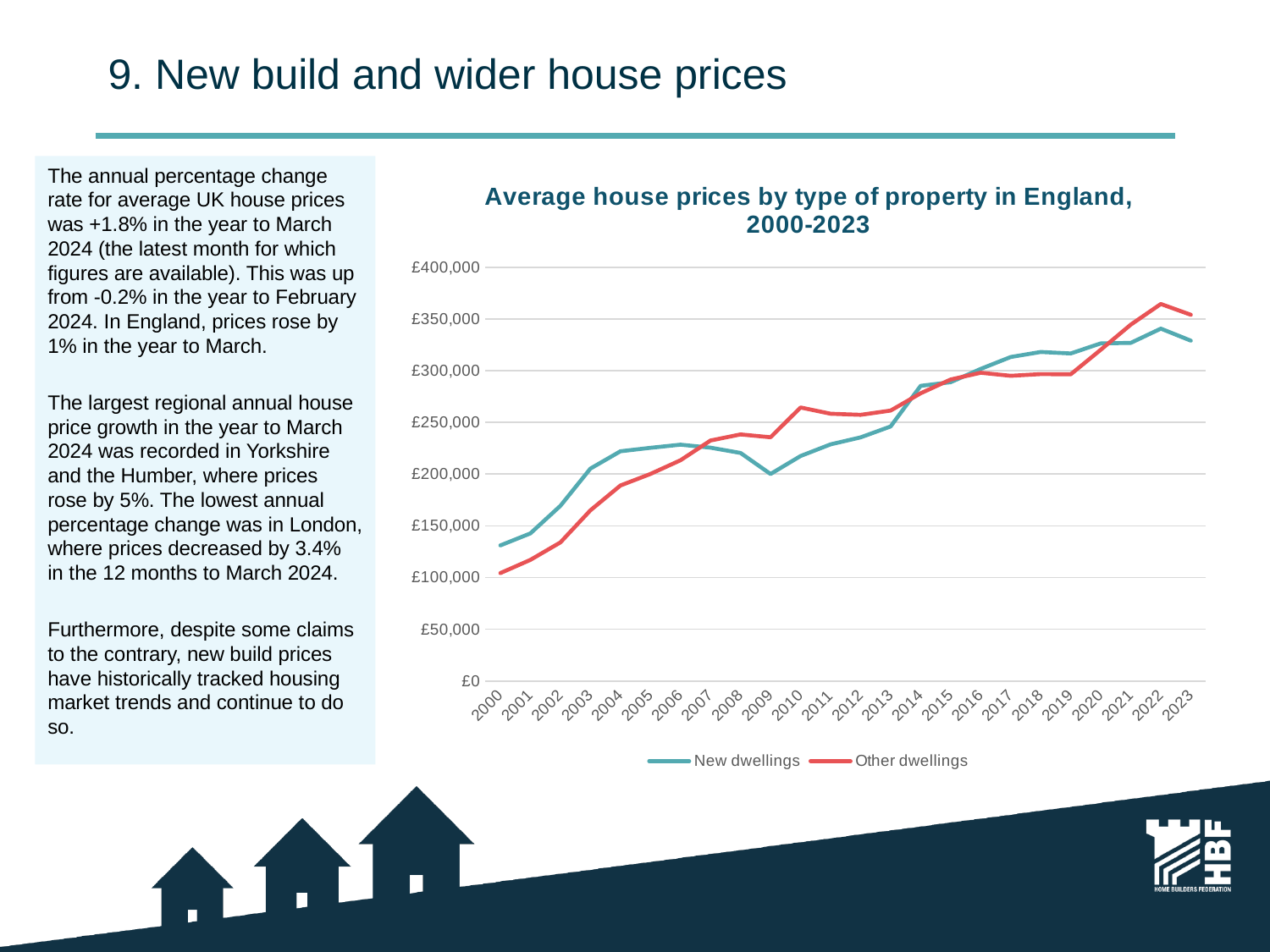
What kind of chart is shown on the slide? Line chart In 2022, which series has the higher value, New dwellings or Other dwellings? Other dwellings Is the value for New dwellings in 2023 greater or less than £350,000? less Is the value for Other dwellings in 2022 greater or less than £350,000? greater Overall, do the values for Other dwellings rise or fall from 2000 to 2023? Rise Is the value for New dwellings in 2004 greater or less than £200,000? greater What is the title of the chart? Average house prices by type of property in England, 2000-2023 In 2003, which series has the higher value, New dwellings or Other dwellings? New dwellings What are the two series named in the chart legend? New dwellings and Other dwellings How many series does the chart legend list? 2 How many years are plotted along the x axis of the chart? 24